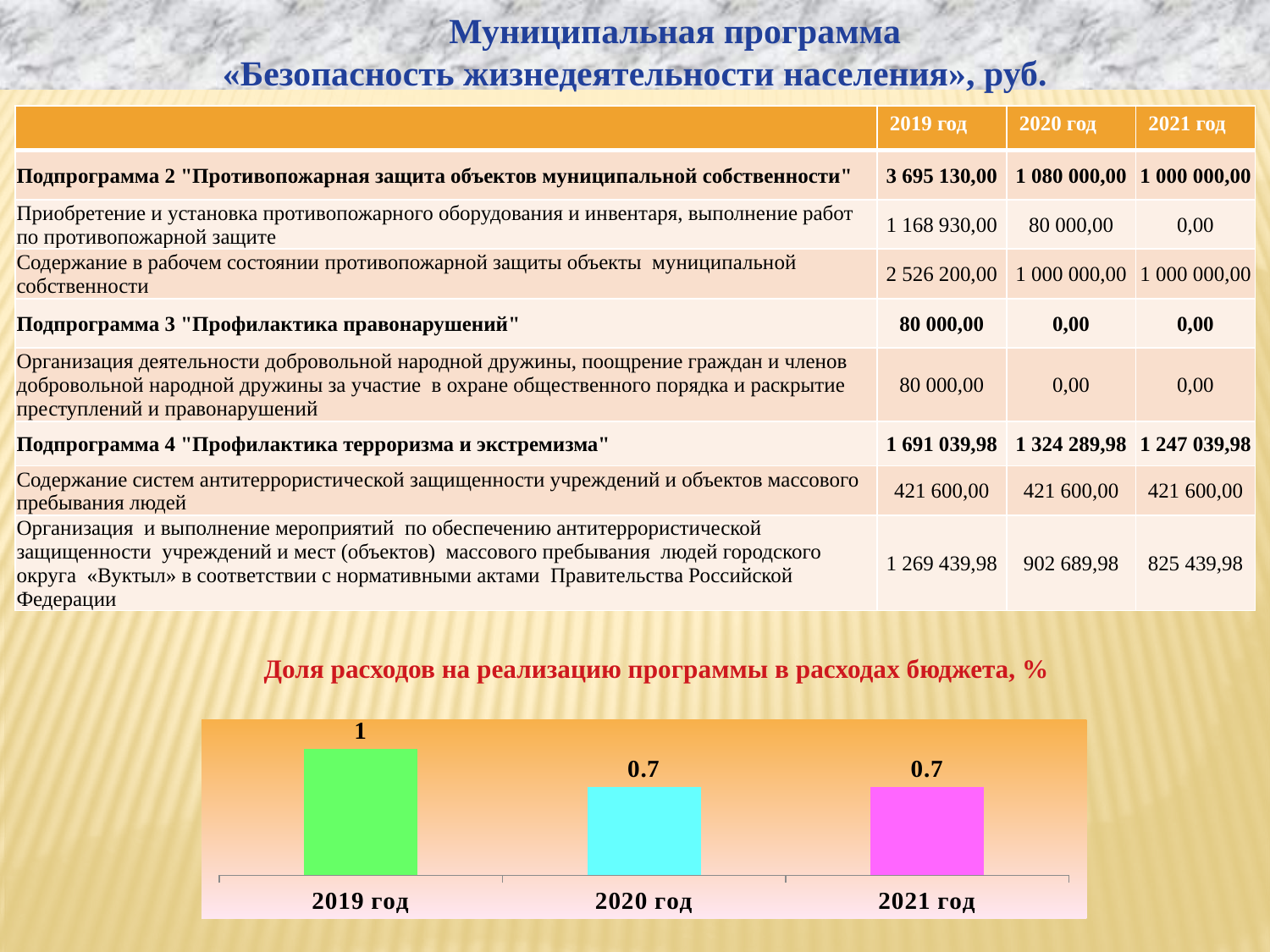
What is the value for 2019 год in the chart 'Доля расходов на реализацию программы в расходах бюджета, %'? 1 What is the value for 2021 год in the chart 'Доля расходов на реализацию программы в расходах бюджета, %'? 0.7 What colour is the bar for 2019 год in the chart 'Доля расходов на реализацию программы в расходах бюджета, %'? green What kind of chart is 'Доля расходов на реализацию программы в расходах бюджета, %'? bar chart What is the title of the chart at the bottom of the slide? Доля расходов на реализацию программы в расходах бюджета, % What is the value for 2020 год in the chart 'Доля расходов на реализацию программы в расходах бюджета, %'? 0.7 Do the values in the chart 'Доля расходов на реализацию программы в расходах бюджета, %' rise or fall from 2019 год to 2020 год? fall What is the difference between the values for 2019 год and 2020 год in the chart 'Доля расходов на реализацию программы в расходах бюджета, %'? 0.3 In the chart 'Доля расходов на реализацию программы в расходах бюджета, %', is the value for 2019 год larger or smaller than the value for 2021 год? larger How many categories are shown in the chart 'Доля расходов на реализацию программы в расходах бюджета, %'? 3 Which year has the highest value in the chart 'Доля расходов на реализацию программы в расходах бюджета, %'? 2019 год